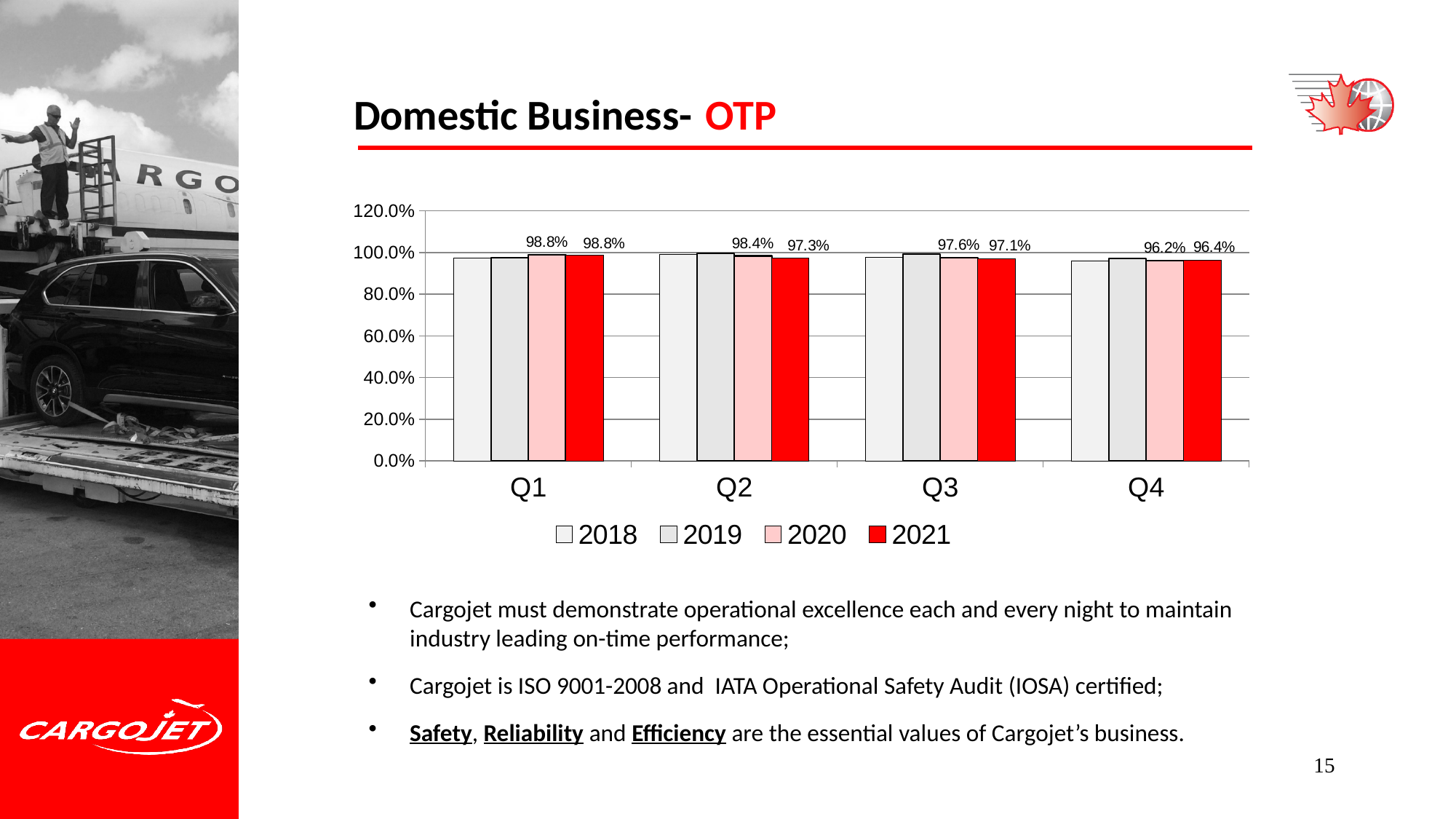
Is the value for 2018 in Q1 greater or less than 80.0%? greater How many quarters are shown on the x axis? 4 What is the value for 2020 in Q2? 98.4% Which quarter has the highest value for the 2021 series? Q1 What is the difference between the 2020 and 2021 values in Q2? 1.1% Which quarter has the lowest value for the 2020 series? Q4 In Q2, which is larger: the 2020 value or the 2021 value? 2020 What is the value for 2021 in Q1? 98.8% What is the value for 2020 in Q4? 96.2% How many series does the legend list? 4 What is the value for 2021 in Q3? 97.1% Do the 2021 values rise or fall from Q1 to Q4? fall